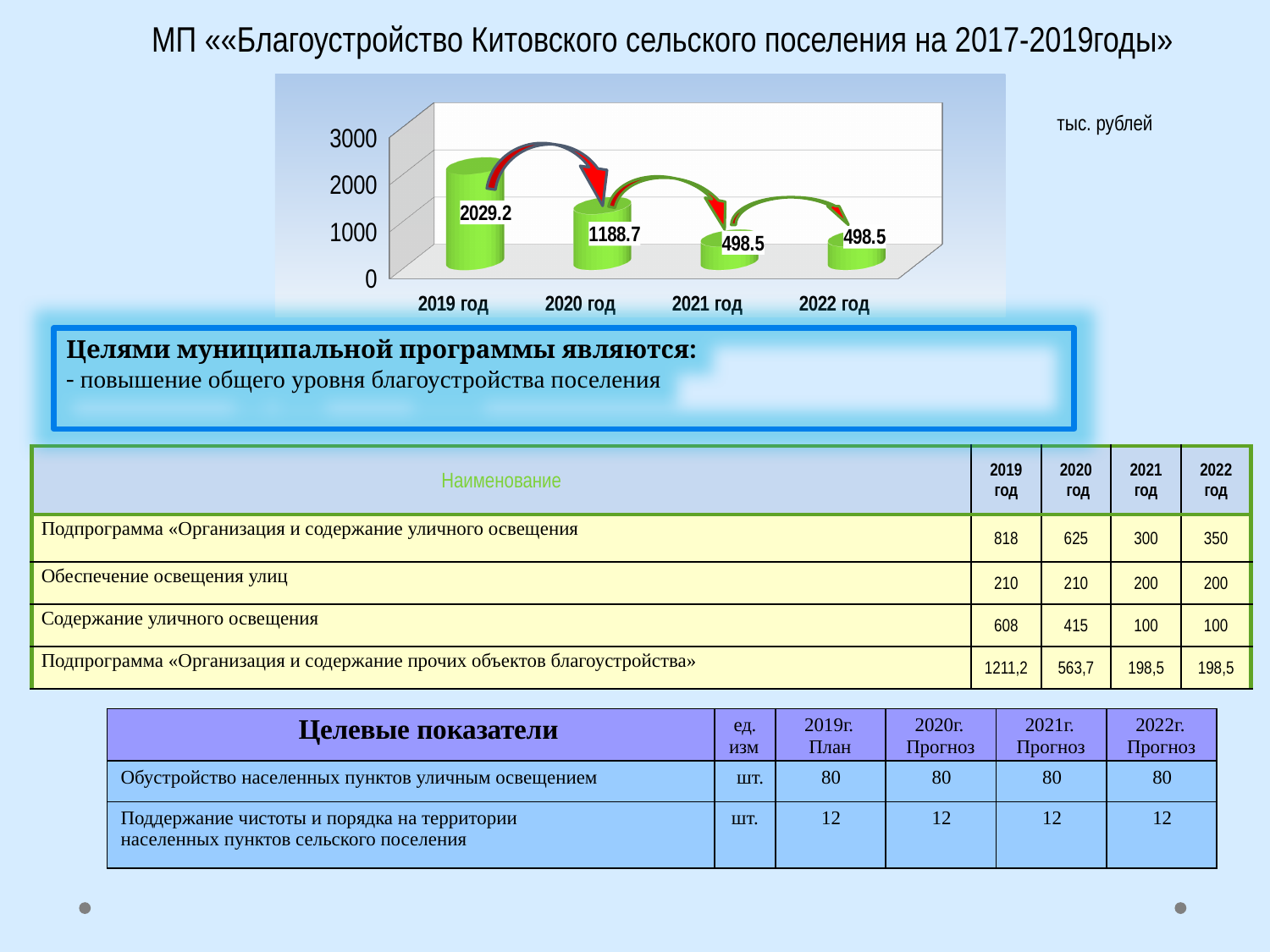
What is the value for 2020 год in the chart? 1188.7 Is the value for 2019 год greater or less than 2000? greater What is the difference between the values for 2019 год and 2020 год? 840.5 What is the difference between the values for 2020 год and 2021 год? 690.2 Is the value for 2021 год greater or less than 1000? less How many years are shown on the x axis of the chart? 4 Which is larger, the value for 2019 год or the value for 2020 год? 2019 год Do the values in the chart rise or fall from 2019 год to 2021 год? fall Which year has the highest value in the chart? 2019 год What is the value for 2021 год in the chart? 498.5 What is the value for 2019 год in the chart? 2029.2 What kind of chart is shown on the slide? bar chart